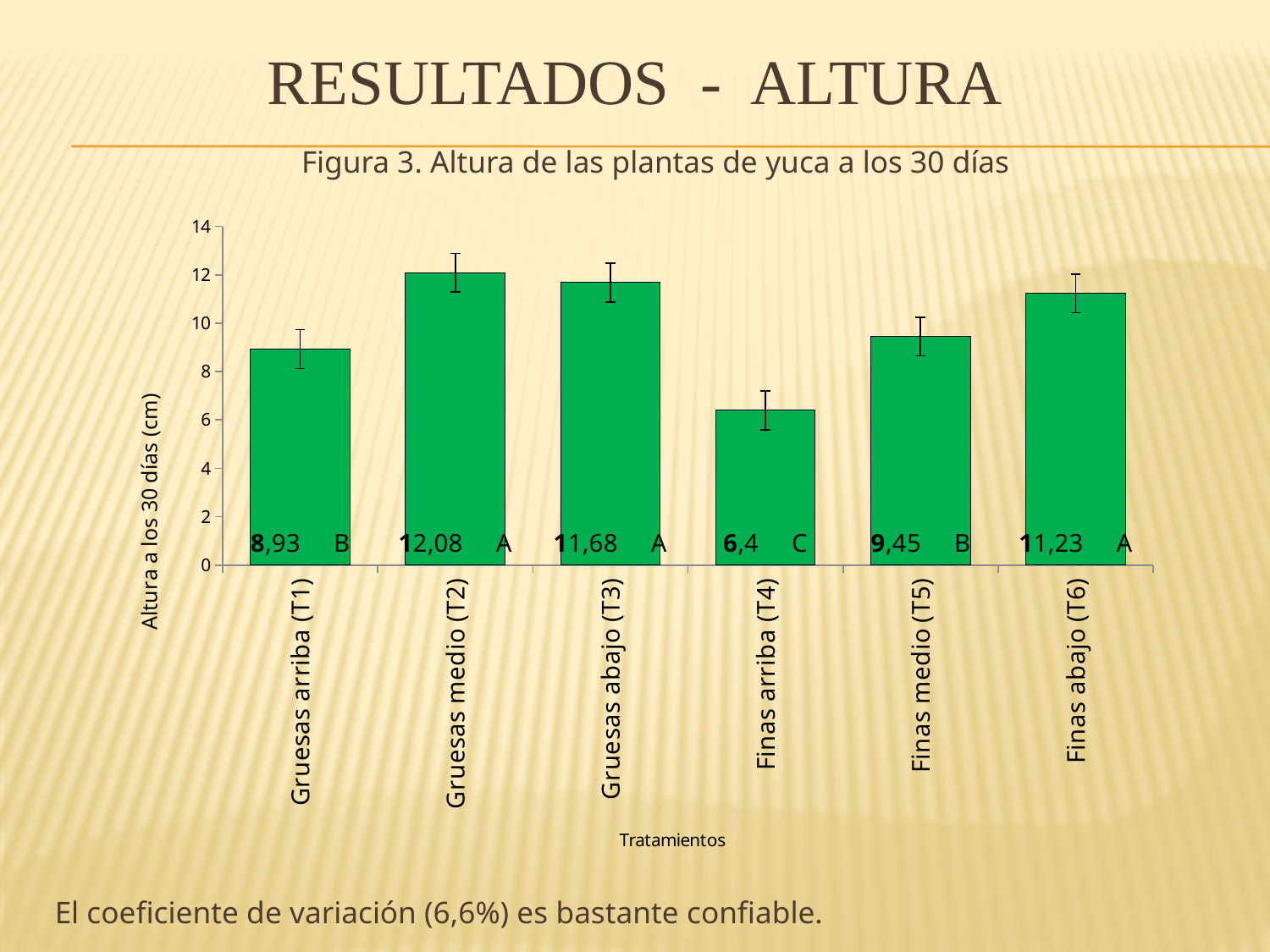
What is the height value shown for Finas arriba (T4)? 6,4 What is the label of the y axis? Altura a los 30 días (cm) Is the value for Gruesas abajo (T3) greater or less than 10? greater How many treatments are shown on the x axis? 6 What is the difference between the values for Gruesas medio (T2) and Finas arriba (T4)? 5,68 What is the height value shown for Finas abajo (T6)? 11,23 What is the height value shown for Gruesas medio (T2)? 12,08 What is the title of the figure shown on the slide? Figura 3. Altura de las plantas de yuca a los 30 días Which is larger, the value for Gruesas arriba (T1) or Finas medio (T5)? Finas medio (T5) Which treatment has the lowest plant height? Finas arriba (T4) What kind of chart is shown on the slide? bar chart Which treatment has the highest plant height? Gruesas medio (T2)